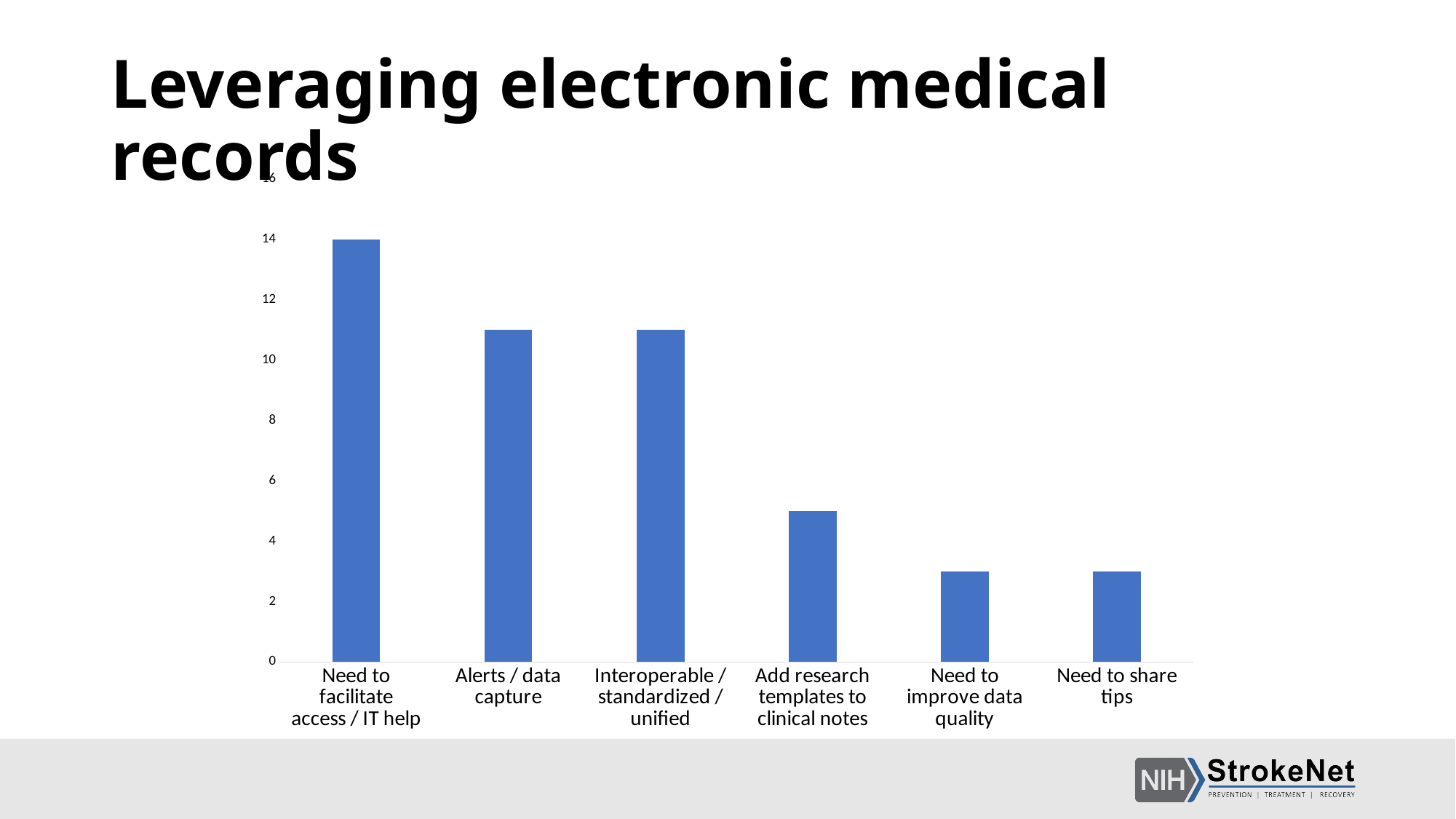
Is the value for "Alerts / data capture" greater or less than 10? greater Is the value for "Interoperable / standardized / unified" greater or less than 12? less What kind of chart is shown on the slide? bar chart Do the bar values generally rise or fall from left to right along the x axis? fall Which category has the highest bar in the chart? Need to facilitate access / IT help Which is larger, the value for "Alerts / data capture" or the value for "Add research templates to clinical notes"? Alerts / data capture Is the value for "Add research templates to clinical notes" greater or less than 4? greater What is the title of the slide containing the chart? Leveraging electronic medical records What is the value for "Need to facilitate access / IT help"? 14 How many categories are shown on the x axis of the chart? 6